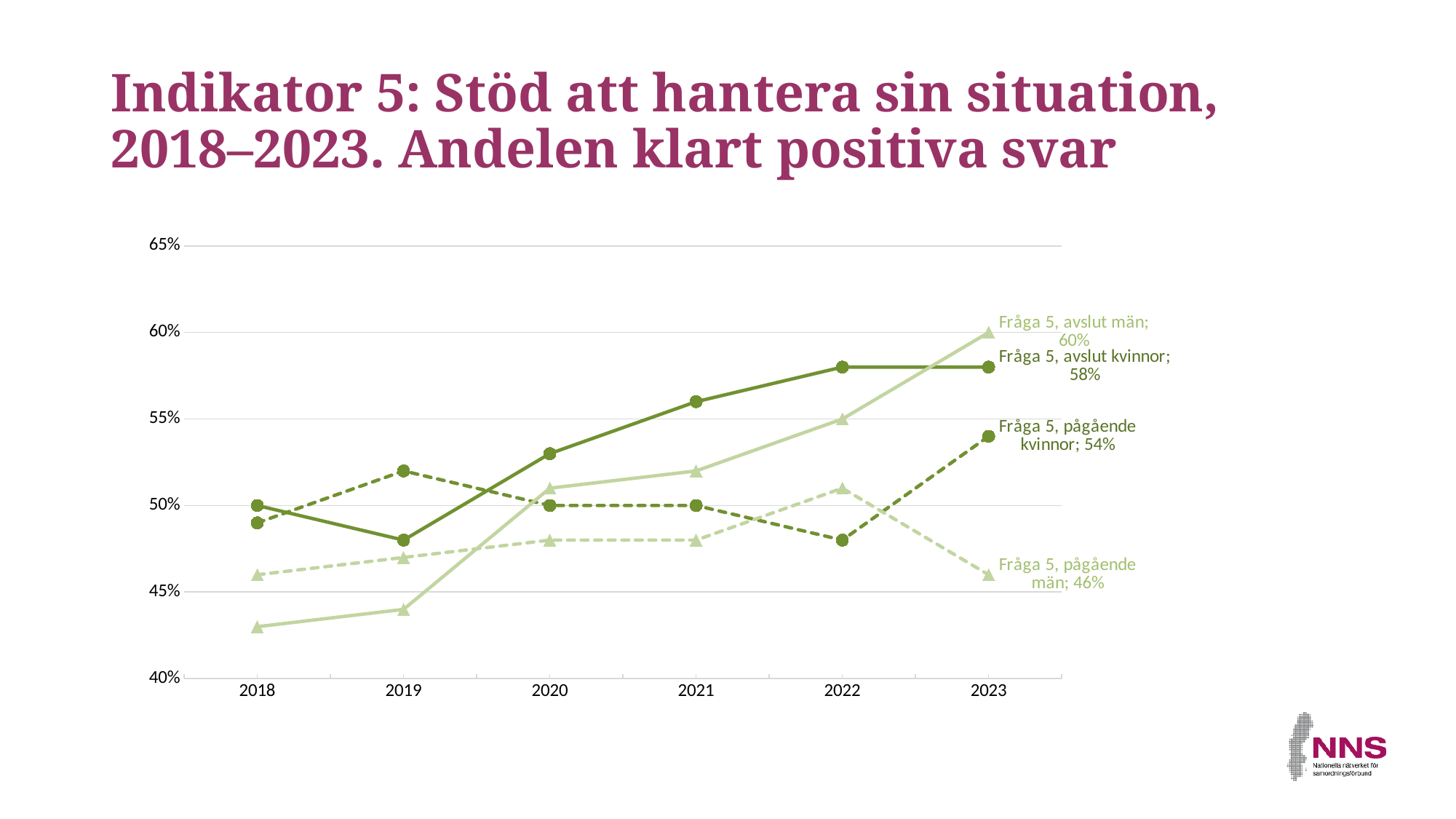
What is the value for 'Fråga 5, avslut män' in 2023? 60% What is the value for 'Fråga 5, pågående män' in 2023? 46% What is the value for 'Fråga 5, avslut kvinnor' in 2023? 58% Which series has the lowest value in 2023? Fråga 5, pågående män In 2023, which is larger: 'Fråga 5, avslut kvinnor' or 'Fråga 5, pågående kvinnor'? Fråga 5, avslut kvinnor What is the value for 'Fråga 5, pågående kvinnor' in 2023? 54% What kind of chart is shown on the slide? line chart Which series has the highest value in 2023? Fråga 5, avslut män Is the value for 'Fråga 5, avslut män' in 2018 greater or less than 45%? less How many series are plotted on the chart? 4 What is the difference between 'Fråga 5, avslut män' and 'Fråga 5, pågående män' in 2023? 14 percentage points How many years are shown on the x axis? 6